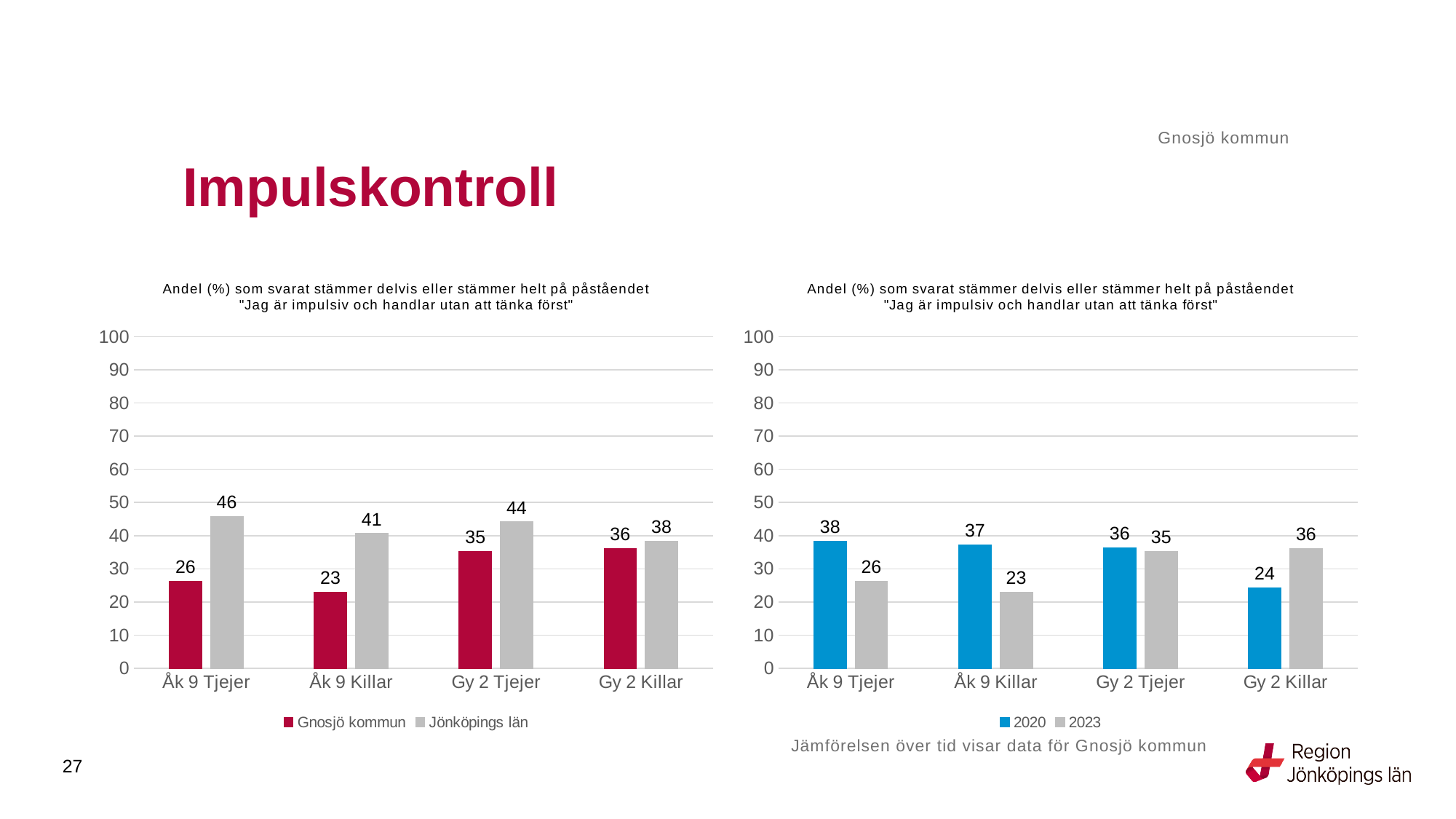
In the right chart, what is the 2023 value for Åk 9 Killar? 23 In the left chart, what is the value for Jönköpings län for Gy 2 Tjejer? 44 In the left chart, which category has the lowest Gnosjö kommun value? Åk 9 Killar In the right chart, what is the 2020 value for Gy 2 Killar? 24 In the right chart, what is the difference between the 2020 and 2023 values for Åk 9 Killar? 14 In the left chart, how many series does the legend list? 2 In the right chart, which is larger for Gy 2 Killar, the 2020 value or the 2023 value? 2023 In the left chart, what is the value for Gnosjö kommun for Åk 9 Tjejer? 26 In the right chart, how many categories are shown on the x axis? 4 In the left chart, which category has the highest Jönköpings län value? Åk 9 Tjejer In the left chart, what is the difference between Jönköpings län and Gnosjö kommun for Åk 9 Tjejer? 20 What kind of chart is the right chart? Bar chart